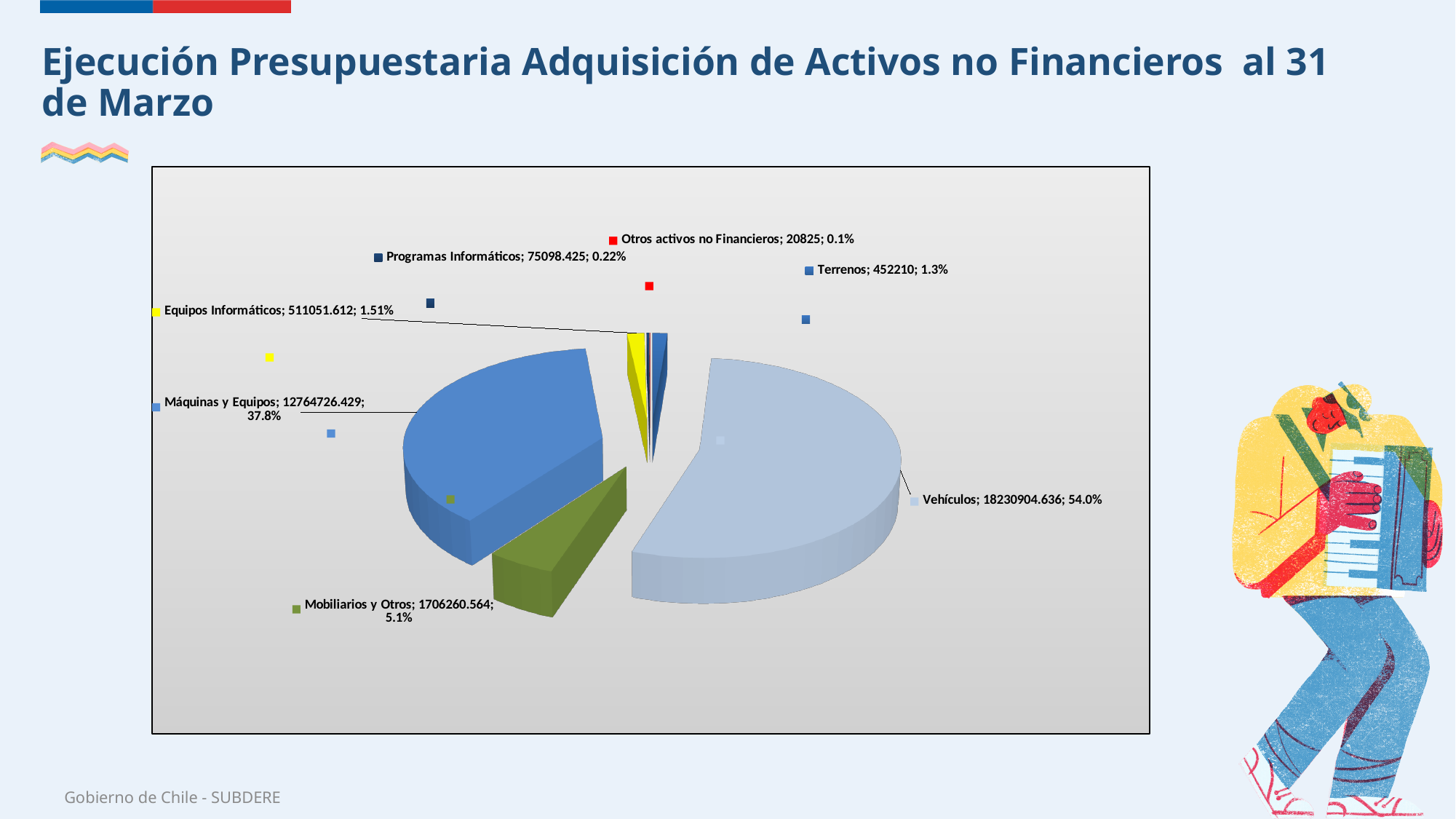
Which category has the largest slice of the pie chart? Vehículos What kind of chart is shown on the slide? pie chart What percentage share does Mobiliarios y Otros have? 5.1% What percentage share does Máquinas y Equipos have in the pie chart? 37.8% What is the value shown for Terrenos? 452210 What is the value shown for Vehículos? 18230904.636 How many categories (slices) does the pie chart show? 7 What colour is the slice for Mobiliarios y Otros? green What percentage share does Vehículos have in the pie chart? 54.0% Which category has the smallest slice of the pie chart? Otros activos no Financieros Which is larger, Equipos Informáticos or Terrenos? Equipos Informáticos What is the value shown for Programas Informáticos? 75098.425